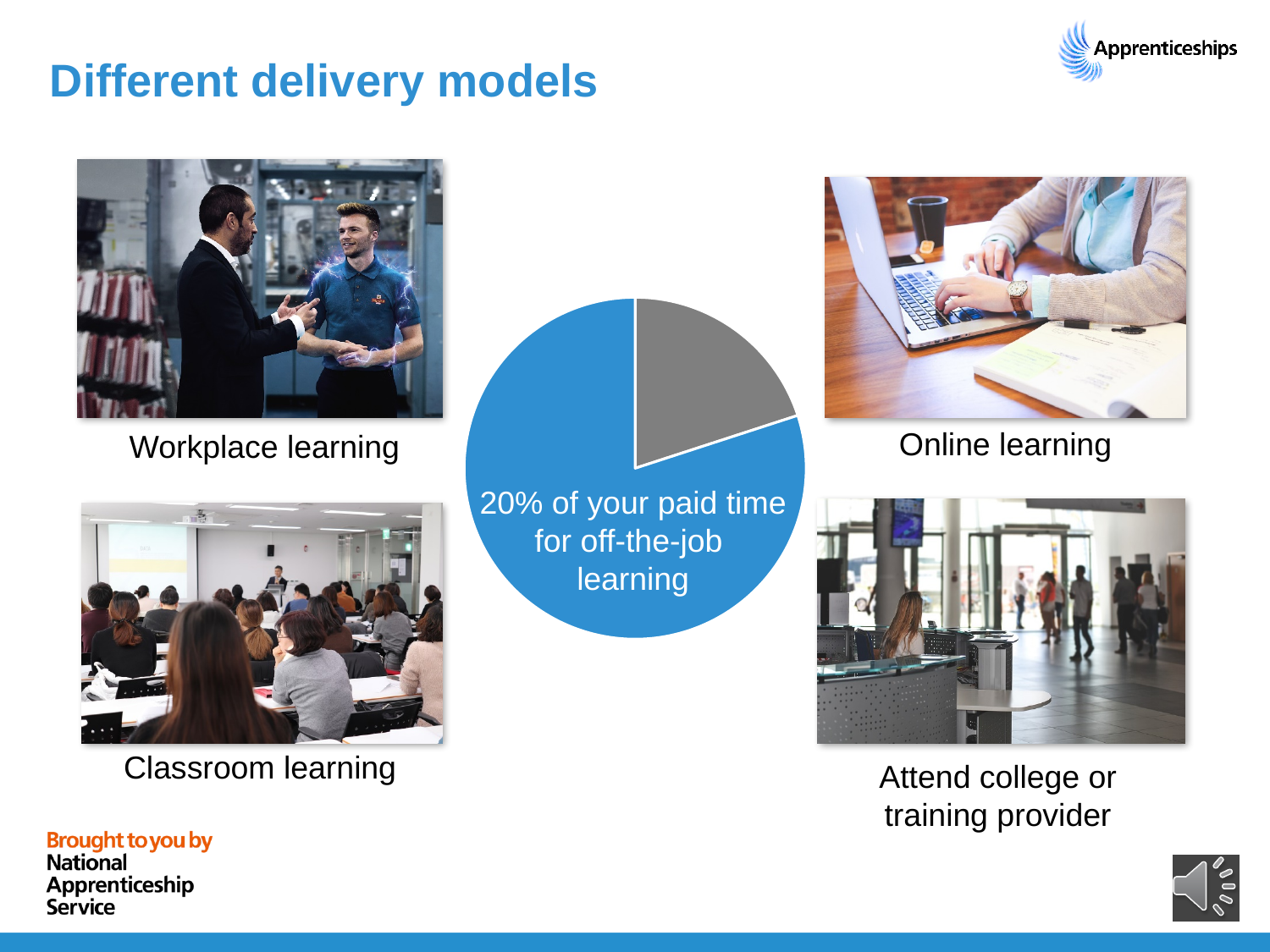
According to the pie chart, what share of your paid time is for off-the-job learning? 20% Does the pie chart have a legend? No How many slices does the pie chart have? 2 What percentage is printed on the pie chart? 20% Which slice of the pie chart is larger, the blue slice or the grey slice? blue Which slice of the pie chart is the smallest? the grey slice What two colours are used for the slices of the pie chart? blue and grey What kind of chart is shown in the centre of the slide? pie chart